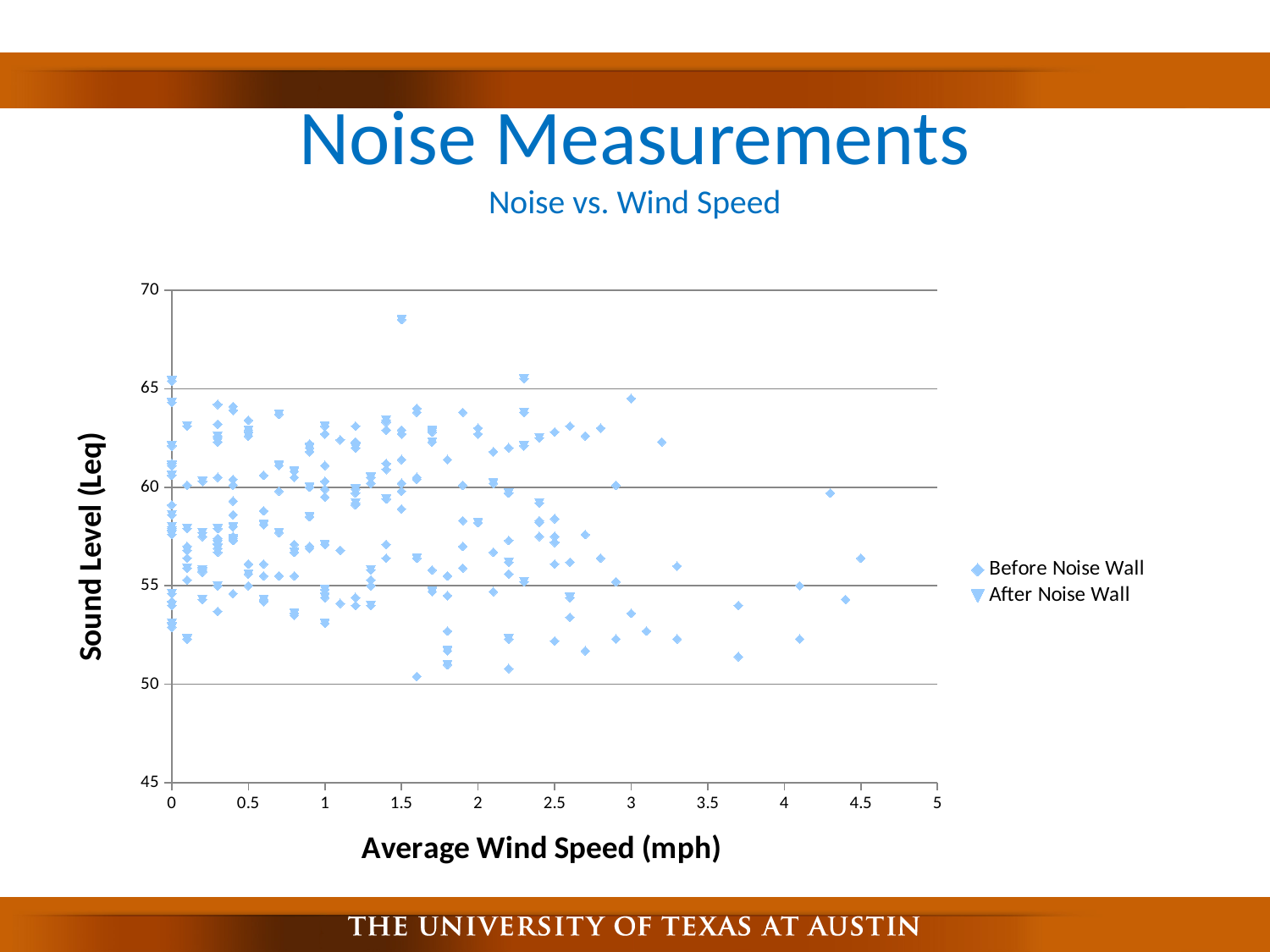
How many series does the legend list? 2 Is the lowest sound level plotted on the chart greater or less than 55? less Is the highest sound level plotted on the chart greater or less than 70? less What kind of chart is shown on the slide? scatter plot What is the title of the chart? Noise vs. Wind Speed Is the lowest sound level plotted on the chart greater or less than 45? greater What are the two series named in the legend? Before Noise Wall and After Noise Wall Which series contains the single highest sound level point on the chart? After Noise Wall Which series contains the point with the highest average wind speed? Before Noise Wall